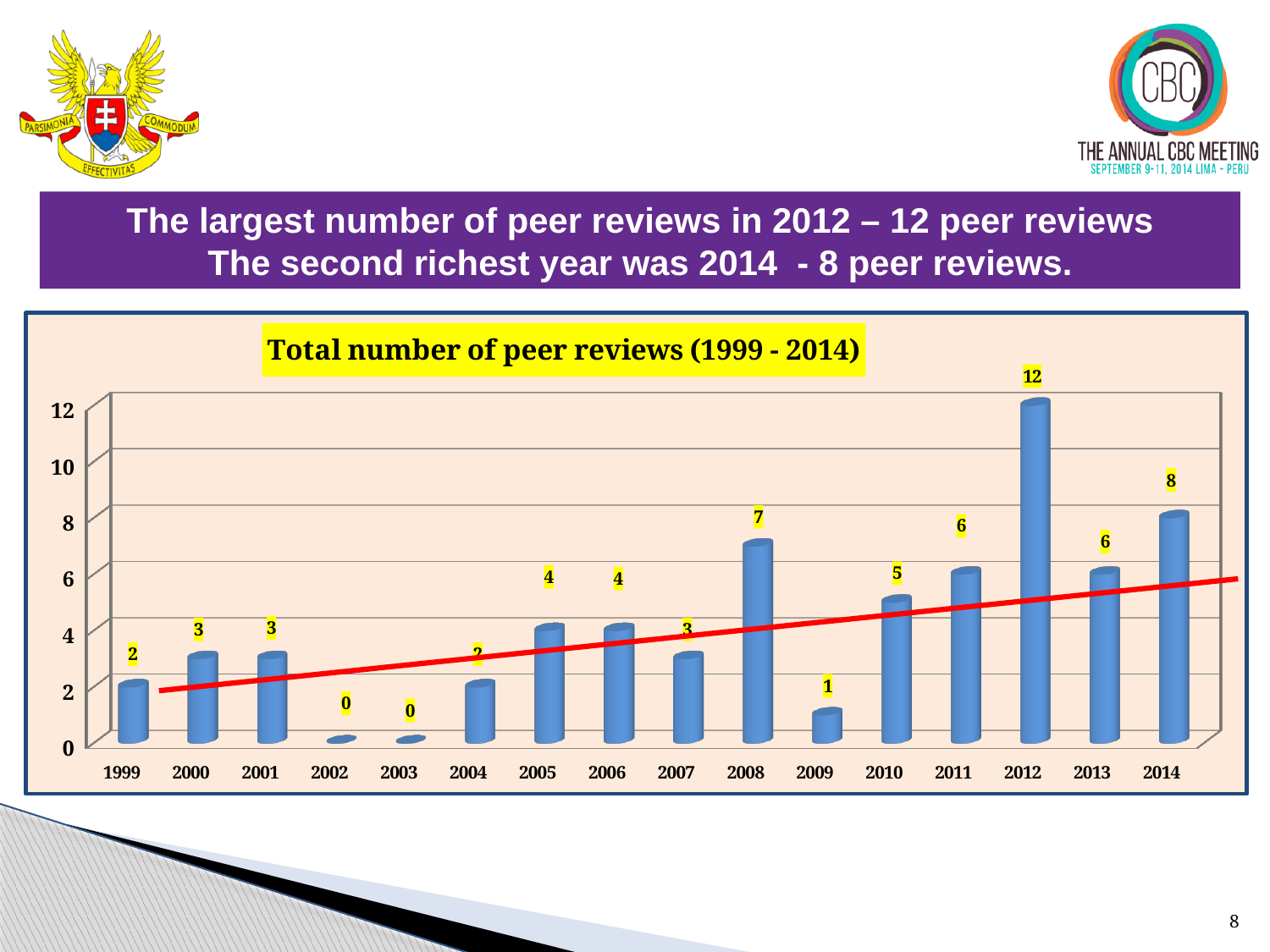
How many years are plotted on the x axis? 16 How many peer reviews were there in 2008? 7 What is the value shown for 2009? 1 What type of chart is shown on the slide? bar chart Which years show a value of 0 peer reviews? 2002 and 2003 Which year has more peer reviews, 2005 or 2011? 2011 Does the red trend line rise or fall from 1999 to 2014? rise What is the difference between the number of peer reviews in 2012 and in 2014? 4 What is the difference between the values for 2008 and 2009? 6 What is the value shown for 2010? 5 What is the title of the chart? Total number of peer reviews (1999 - 2014) Which year has the highest number of peer reviews? 2012